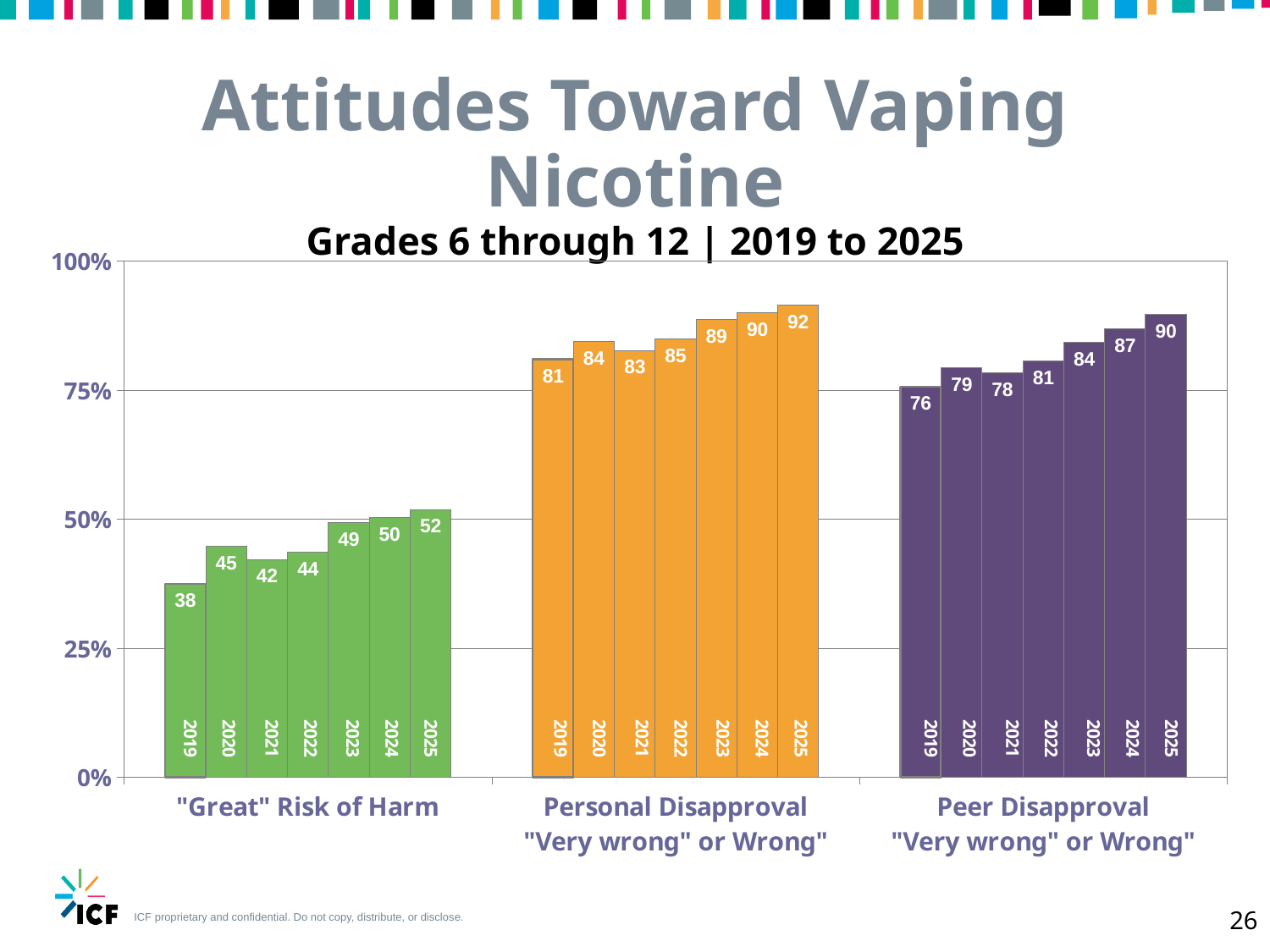
What is the value for "Great" Risk of Harm in 2019? 38 Which year has the highest value for "Great" Risk of Harm? 2025 What is the difference between the Personal Disapproval values for 2025 and 2019? 11 Do the Peer Disapproval values generally rise or fall from 2019 to 2025? Rise Is the value for "Great" Risk of Harm in 2023 greater or less than 50%? less Which year has the lowest value for Peer Disapproval? 2019 How many years are shown for each category group? 7 What kind of chart is shown on the slide? Bar chart What is the title of the chart? Attitudes Toward Vaping Nicotine What is the value for Personal Disapproval in 2025? 92 Which is larger, Personal Disapproval in 2021 or Peer Disapproval in 2021? Personal Disapproval in 2021 What is the value for Peer Disapproval in 2022? 81